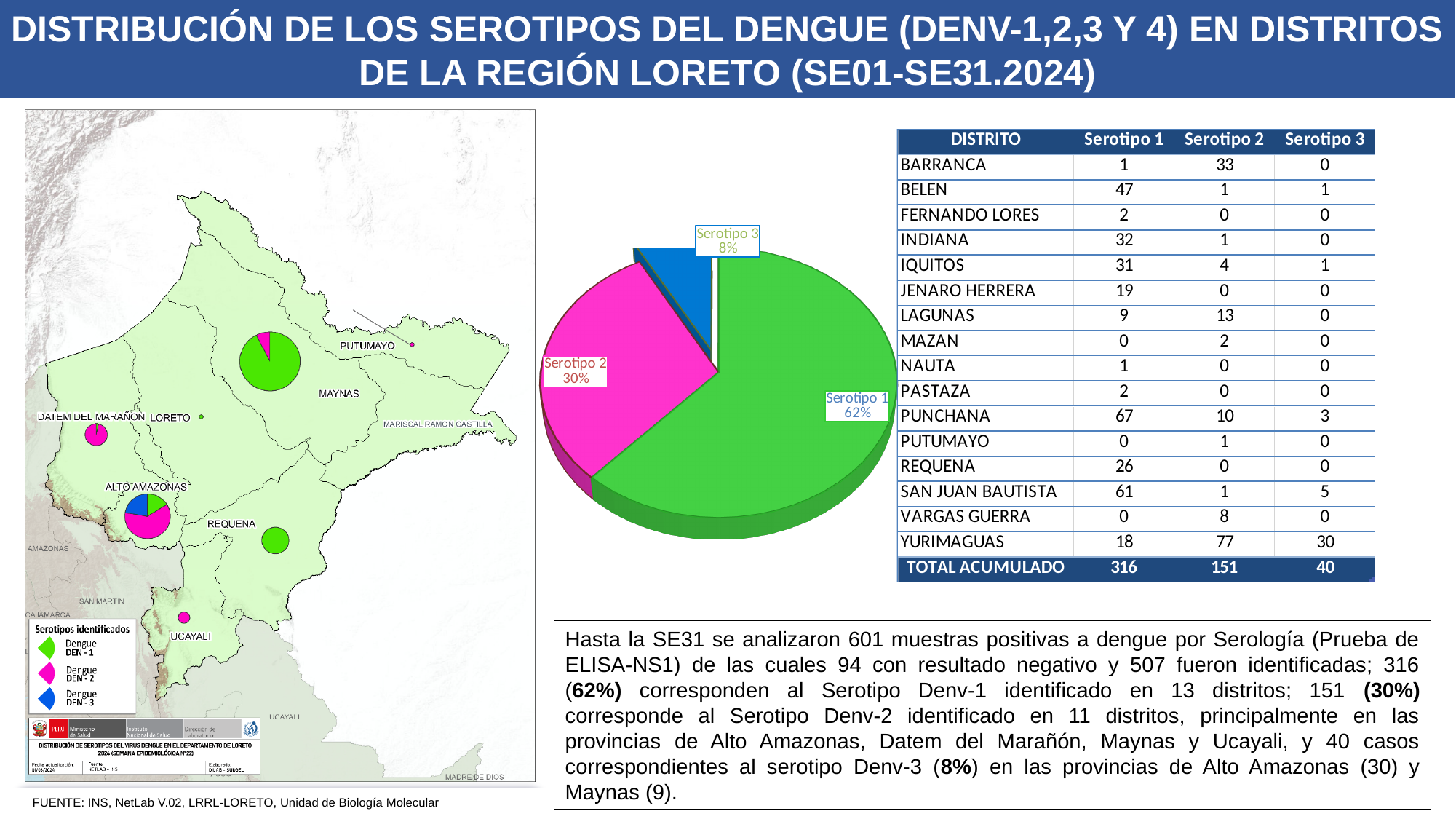
Which serotype has the smallest slice in the pie chart? Serotipo 3 How many slices does the pie chart have? 3 What kind of chart is shown in the centre of the slide? pie chart In the pie chart, which is larger: the share of Serotipo 2 or the share of Serotipo 3? Serotipo 2 What colour is the Serotipo 1 slice in the pie chart? green In the pie chart, what is the difference in percentage points between Serotipo 1 and Serotipo 2? 32 In the pie chart, what is the difference in percentage points between Serotipo 2 and Serotipo 3? 22 What colour is the Serotipo 3 slice in the pie chart? blue In the pie chart, what share does Serotipo 1 have? 62% Which serotype has the largest slice in the pie chart? Serotipo 1 In the pie chart, what share does Serotipo 3 have? 8% In the pie chart, what share does Serotipo 2 have? 30%